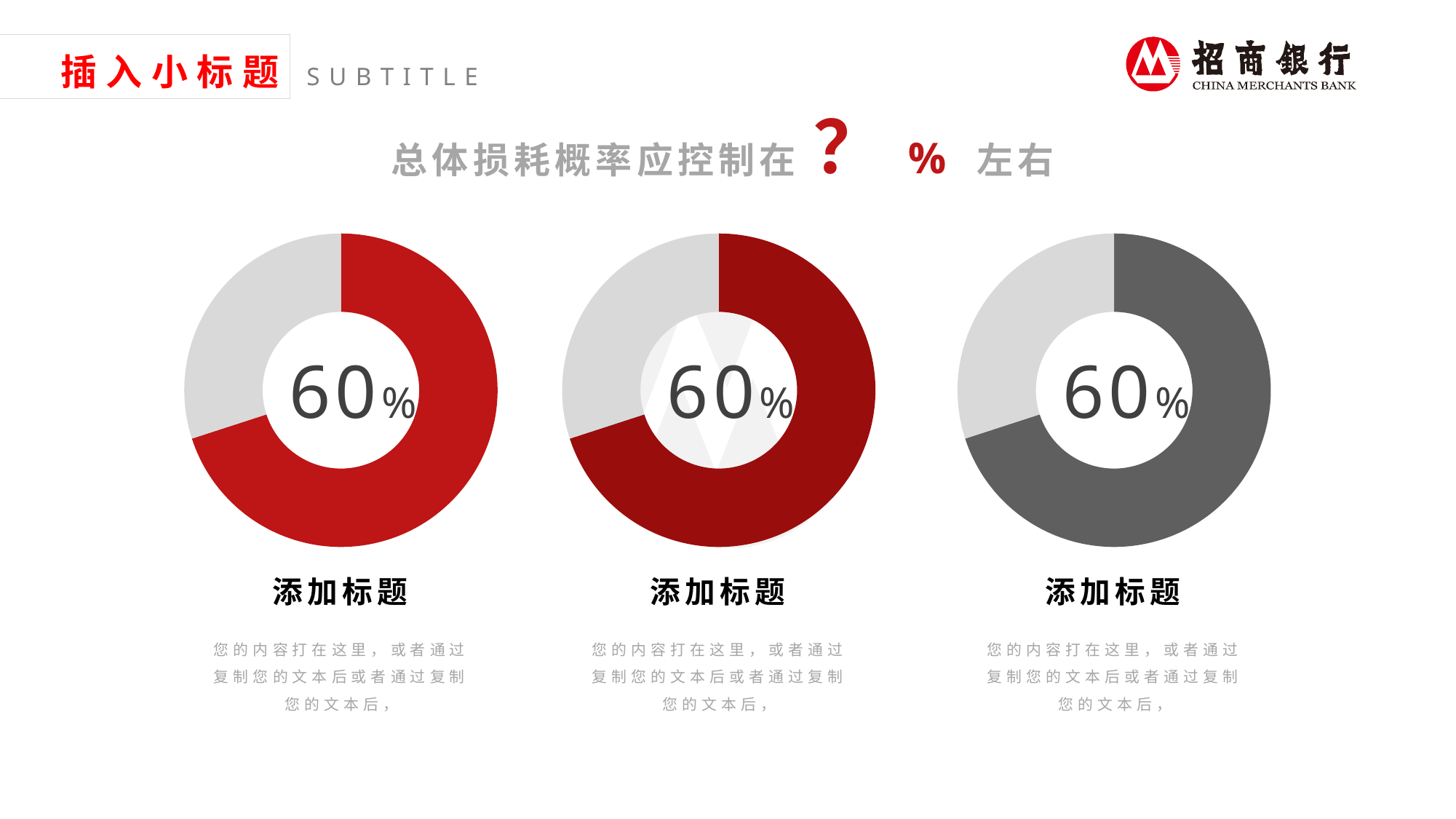
Is the value shown in the middle donut chart greater or less than 50%? greater What colour is the filled segment of the right donut chart? Dark gray How many segments does each donut chart have? 2 Which of the three donut charts shows the highest percentage, or are they all equal? All equal (60%) What is the label printed below each donut chart? 添加标题 What percentage is printed in the centre of the right donut chart? 60% What percentage is printed in the centre of the left donut chart? 60% What percentage is printed in the centre of the middle donut chart? 60% What kind of chart is shown on the left of the slide? Pie (donut) chart How many donut charts are shown on the slide? 3